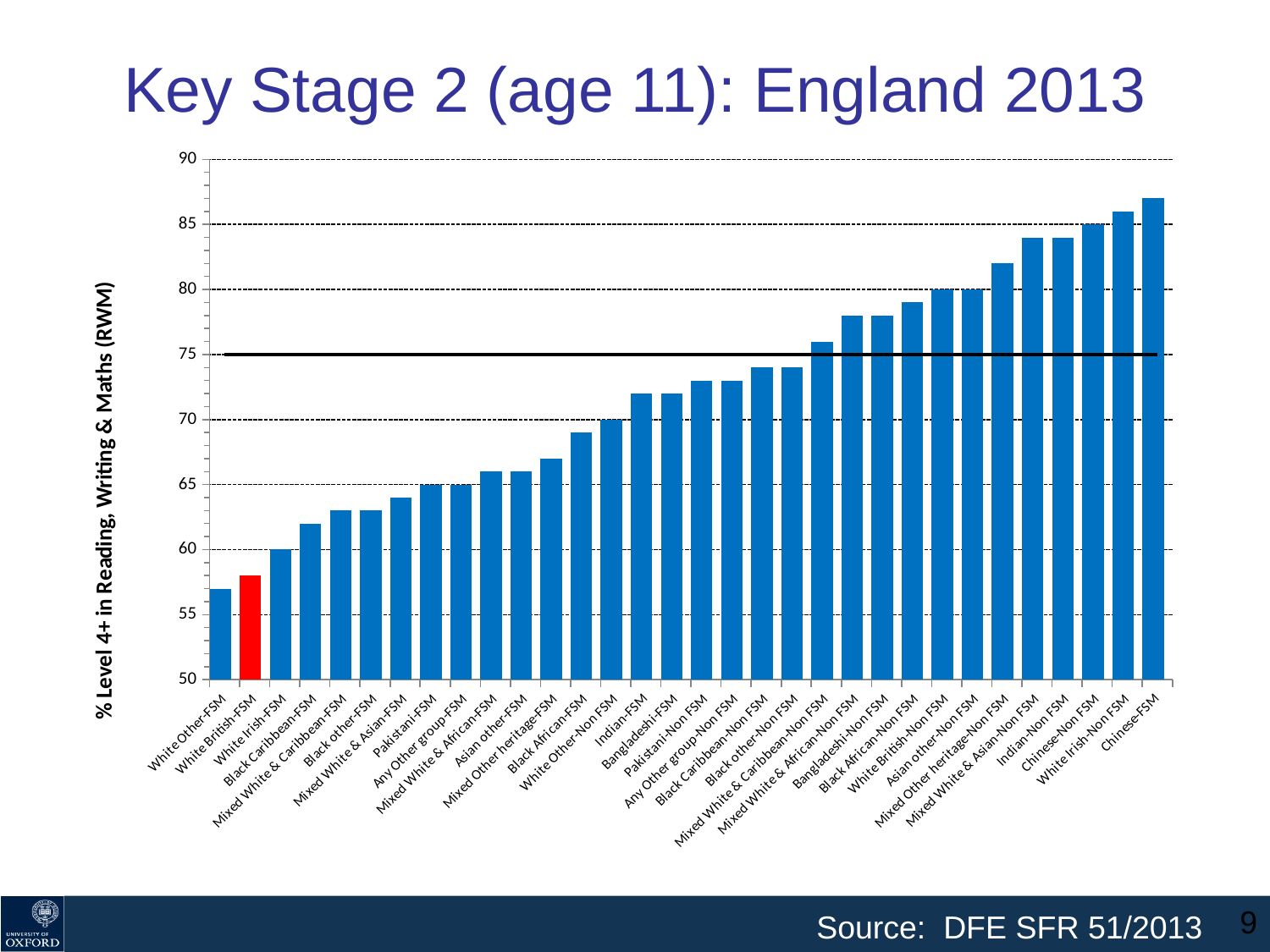
Is the value for Black African-FSM greater or less than 70? less Which is larger, the value for Chinese-Non FSM or the value for Bangladeshi-FSM? Chinese-Non FSM Which category has the highest value? Chinese-FSM Is the value for Chinese-FSM greater or less than 85? greater Do the values rise or fall moving left to right along the x axis? rise What is the title of the y axis? % Level 4+ in Reading, Writing & Maths (RWM) Is the value for Indian-FSM greater or less than 70? greater How many categories (bars) are plotted in the chart? 32 What kind of chart is shown on the slide? bar chart Which category has the lowest value? White Other-FSM Which bar is coloured red in the chart? White British-FSM